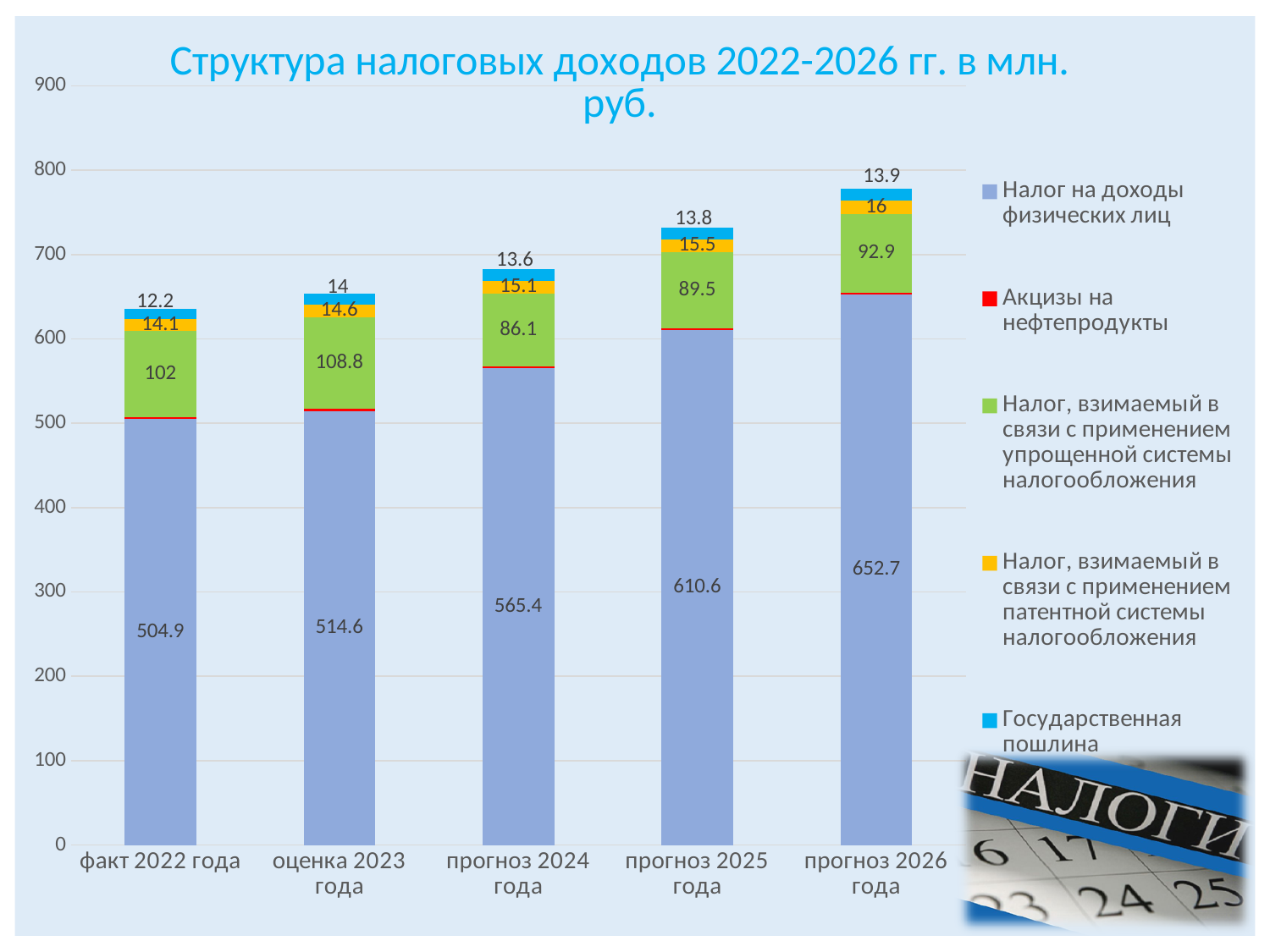
What is the value of Налог, взимаемый в связи с применением патентной системы налогообложения for прогноз 2025 года? 15.5 How many series does the legend list? 5 Is the total height of the stacked bar for прогноз 2026 года greater or less than 700? greater What is the value of Налог, взимаемый в связи с применением упрощенной системы налогообложения for оценка 2023 года? 108.8 What is the value of Налог на доходы физических лиц for прогноз 2026 года? 652.7 How many categories are shown on the x axis? 5 What is the value of Государственная пошлина for факт 2022 года? 12.2 Which category has the lowest value for Налог, взимаемый в связи с применением упрощенной системы налогообложения? прогноз 2024 года Which category has the highest value for Налог на доходы физических лиц? прогноз 2026 года Which is larger: Налог, взимаемый в связи с применением упрощенной системы налогообложения for факт 2022 года or for прогноз 2026 года? факт 2022 года What kind of chart is shown on the slide? stacked bar chart What is the difference between Налог на доходы физических лиц for прогноз 2025 года and for прогноз 2024 года? 45.2